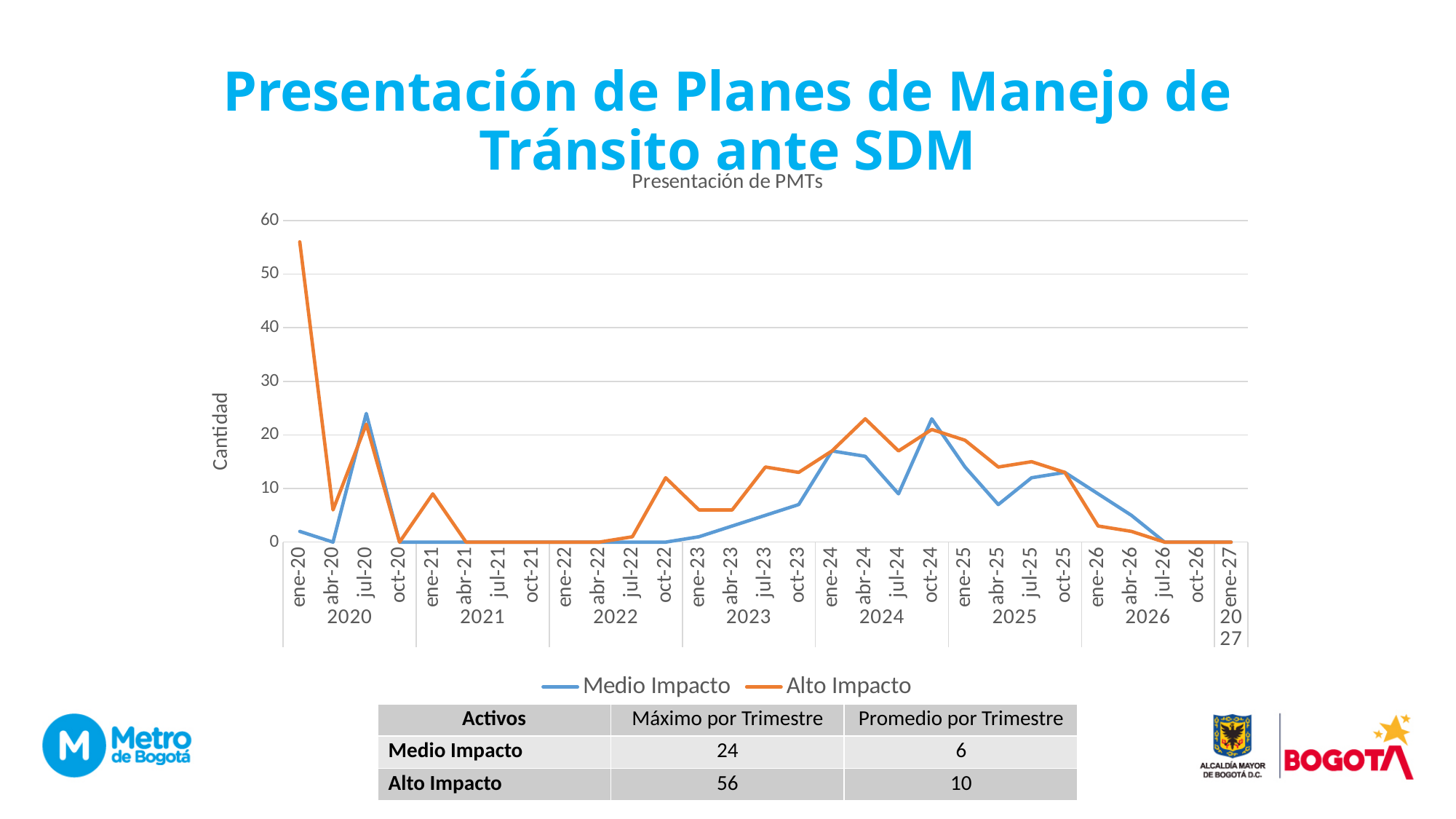
What type of chart is shown on the slide? line chart What is the title of the chart? Presentación de PMTs In which quarter does the Medio Impacto series reach its highest value? jul-20 According to the table, what is the Máximo por Trimestre for Alto Impacto? 56 Is the Alto Impacto value for ene-20 greater or less than 50? greater How many quarterly points are plotted along the x axis? 29 What is the label on the vertical axis of the chart? Cantidad At jul-24, which series has the higher value, Medio Impacto or Alto Impacto? Alto Impacto How many series does the chart legend list? 2 In which quarter does the Alto Impacto series reach its highest value? ene-20 According to the table, what is the Promedio por Trimestre for Medio Impacto? 6 Is the Alto Impacto value for abr-24 greater or less than 20? greater